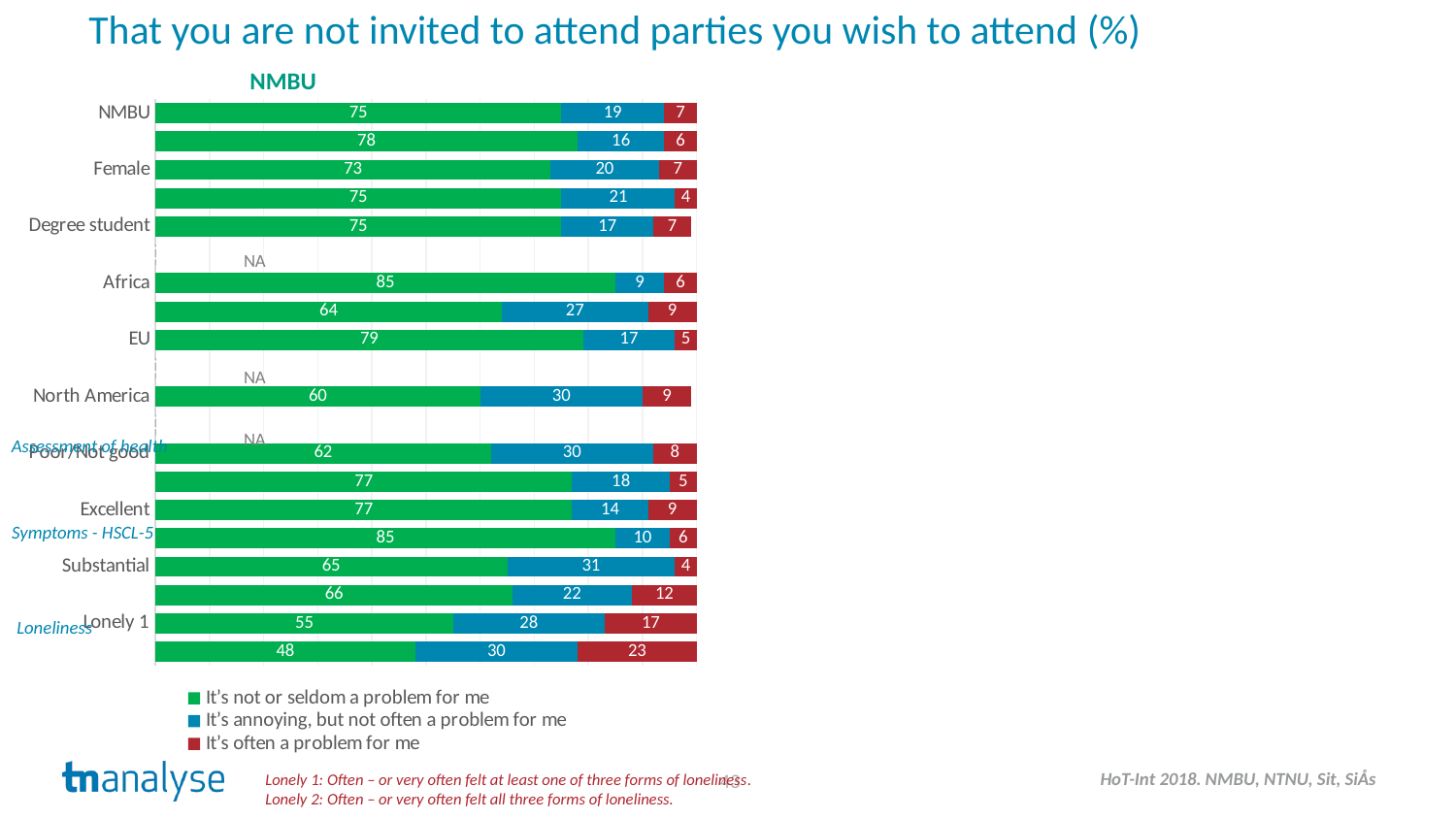
What is the value for NMBU in the series "It's not or seldom a problem for me"? 75 What is the value for Excellent in the series "It's annoying, but not often a problem for me"? 14 Which legend entry is shown in red? It's often a problem for me How many series does the legend list? 3 What is the total of the stacked bar for Lonely 1? 100 What kind of chart is shown on the slide? Stacked bar chart What is the value for North America in the series "It's annoying, but not often a problem for me"? 30 Which has the larger value for "It's not or seldom a problem for me": Africa or EU? Africa What is the value for Lonely 1 in the series "It's often a problem for me"? 17 What is the difference between Africa and North America in the series "It's not or seldom a problem for me"? 25 Which has the larger value for "It's often a problem for me": Lonely 1 or Substantial? Lonely 1 What is the value for Africa in the series "It's often a problem for me"? 6